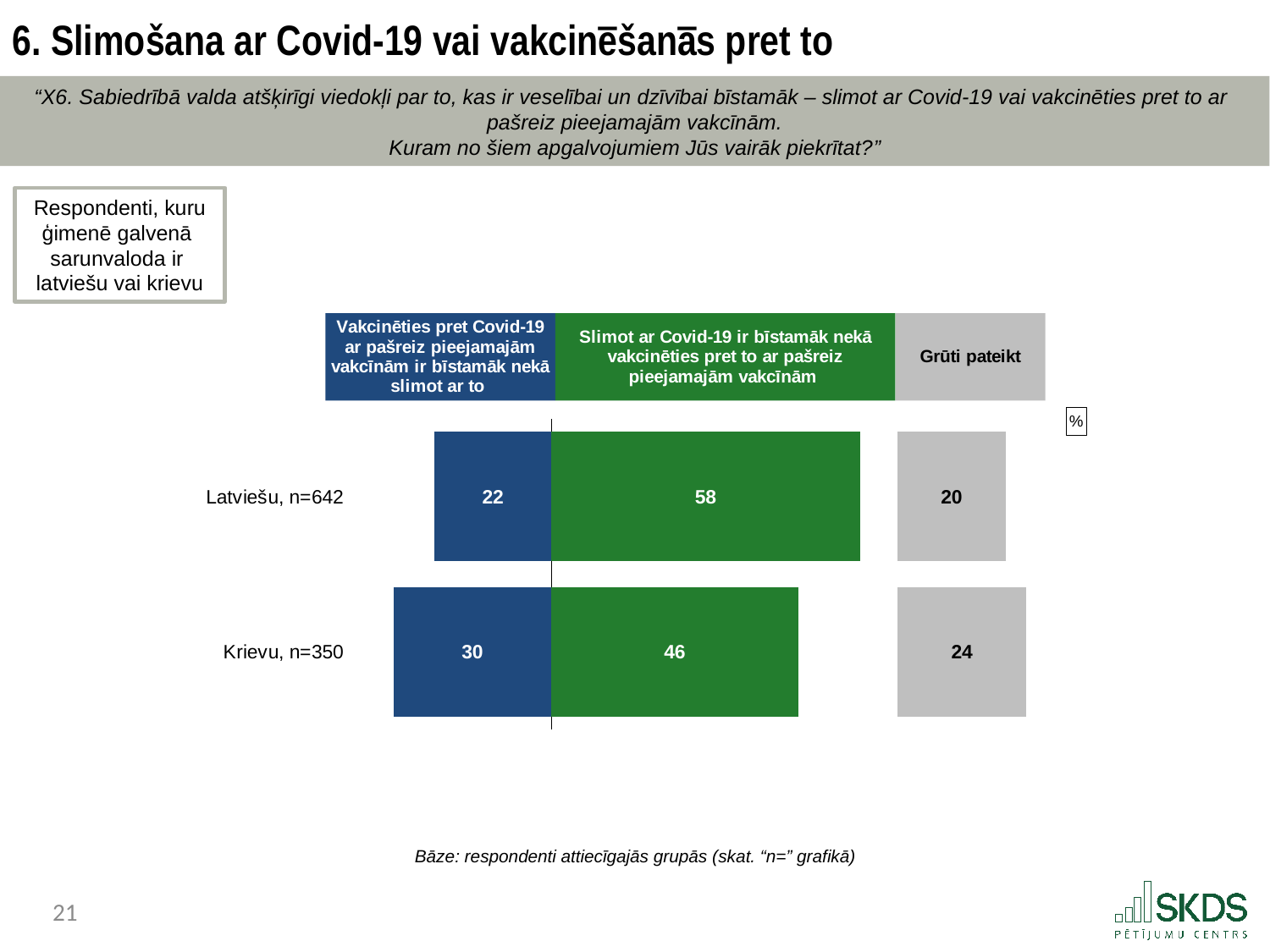
Which group has the higher value for "Slimot ar Covid-19 ir bīstamāk nekā vakcinēties pret to ar pašreiz pieejamajām vakcīnām", Latviešu or Krievu? Latviešu, n=642 How many respondent groups (categories) are shown in the chart? 2 Which colour represents the "Grūti pateikt" series in the chart? Grey What is the total of the three values shown for the Latviešu, n=642 bar? 100 How many series (answer options) does the chart legend list? 3 What type of chart is shown on the slide? Stacked bar chart What is the "Grūti pateikt" value for the Latviešu, n=642 group? 20 What is the "Grūti pateikt" value for the Krievu, n=350 group? 24 What is the difference between the Krievu and Latviešu values for "Vakcinēties pret Covid-19 ar pašreiz pieejamajām vakcīnām ir bīstamāk nekā slimot ar to"? 8 What is the difference between the Latviešu and Krievu values for "Slimot ar Covid-19 ir bīstamāk nekā vakcinēties pret to ar pašreiz pieejamajām vakcīnām"? 12 What percentage of Krievu respondents (n=350) chose "Vakcinēties pret Covid-19 ar pašreiz pieejamajām vakcīnām ir bīstamāk nekā slimot ar to"? 30 What percentage of Latviešu respondents (n=642) chose "Slimot ar Covid-19 ir bīstamāk nekā vakcinēties pret to ar pašreiz pieejamajām vakcīnām"? 58